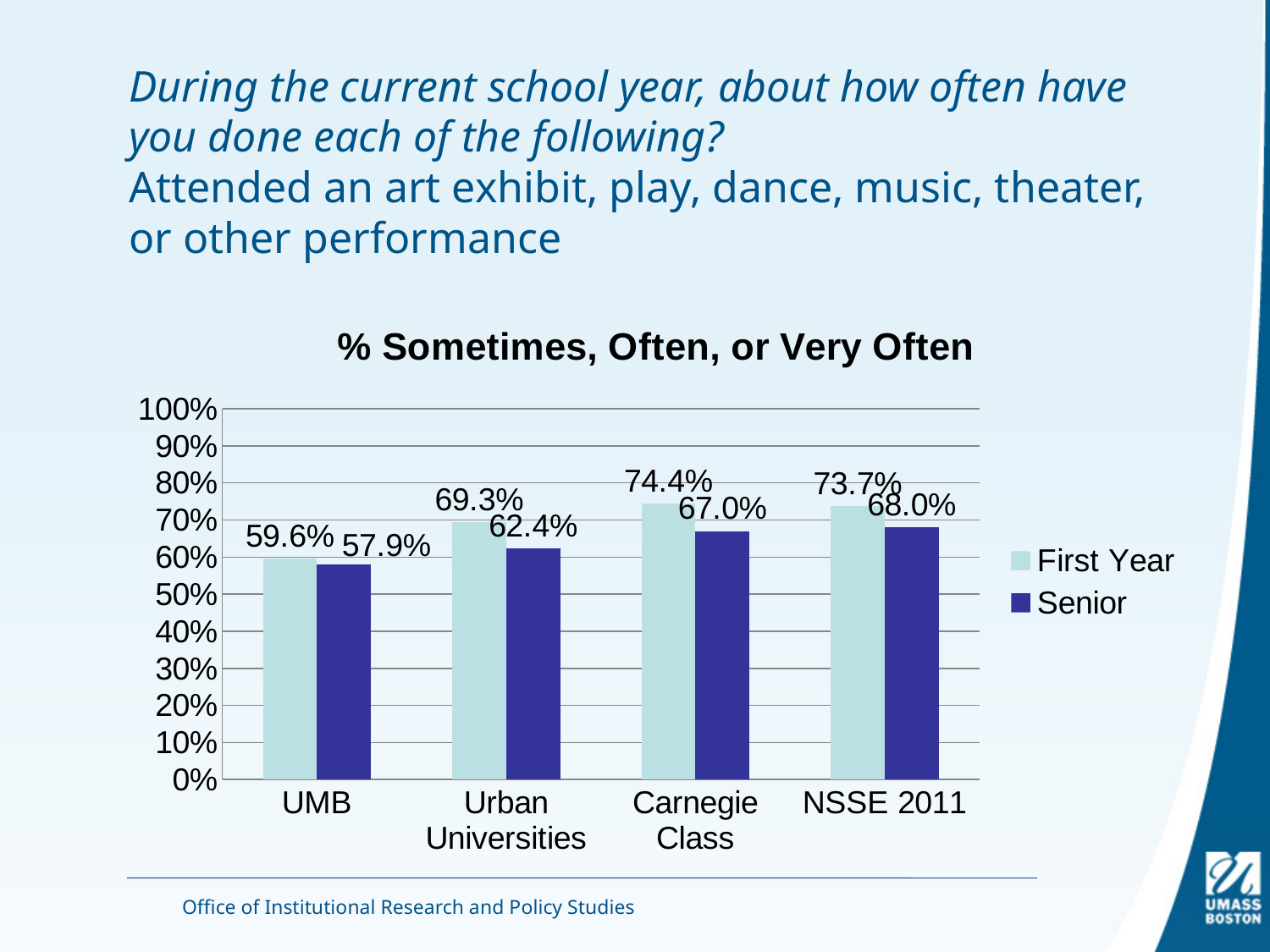
What is the First Year value for Carnegie Class? 74.4% Which category has the lowest Senior value? UMB Which category has the highest First Year value? Carnegie Class What kind of chart is shown on the slide? Bar chart What is the title of the chart? % Sometimes, Often, or Very Often What is the Senior value for Urban Universities? 62.4% What is the Senior value for NSSE 2011? 68.0% What is the difference between the First Year and Senior values for Carnegie Class? 7.4% Which is larger for Urban Universities, the First Year value or the Senior value? First Year How many categories are shown on the x axis? 4 How many series does the legend list? 2 What is the First Year value for UMB? 59.6%